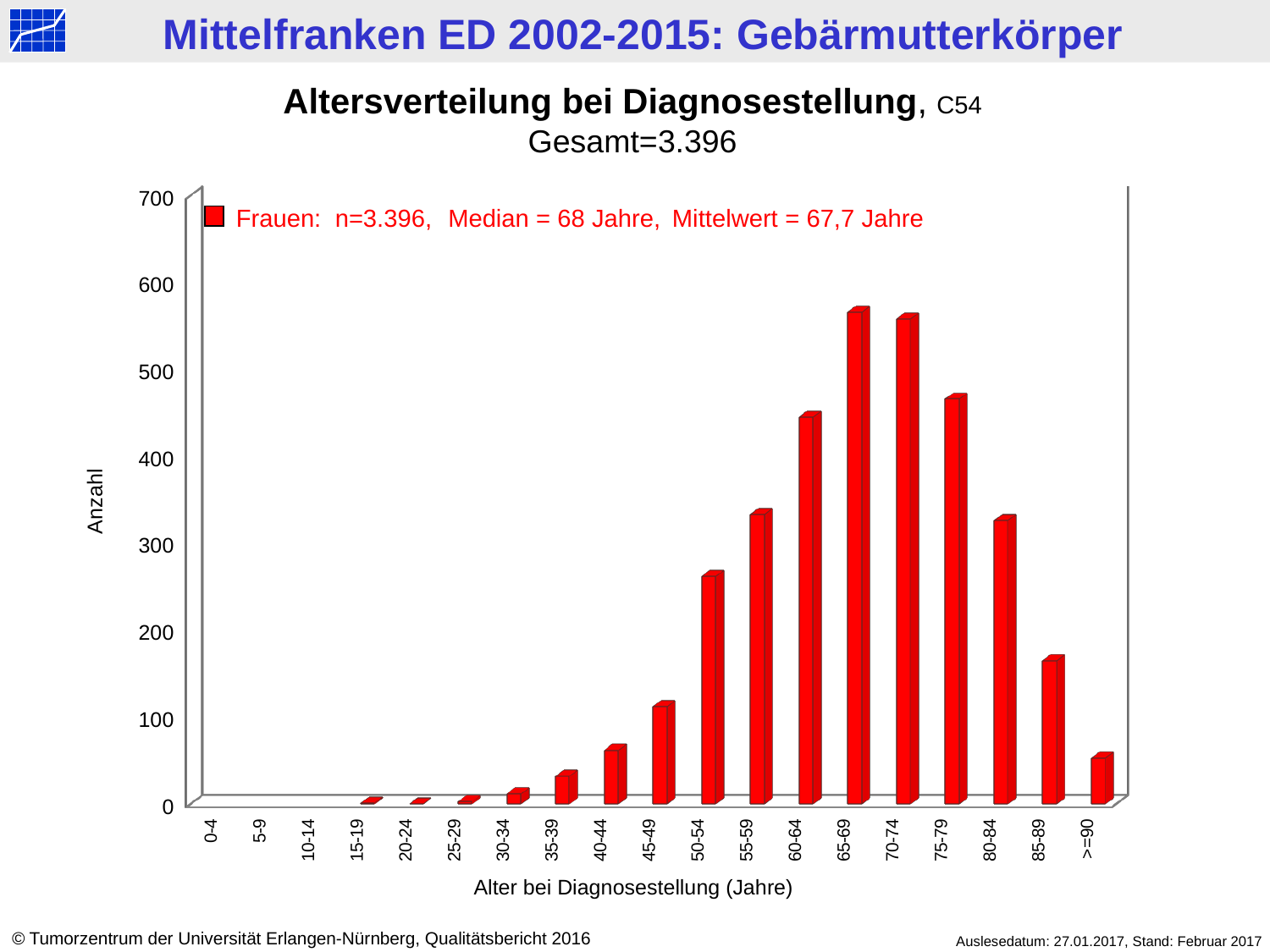
How many series does the legend list? 1 Is the value for the 40-44 age group greater or less than 100? less What is the label of the y axis? Anzahl Which age group has the larger value, 50-54 or 85-89? 50-54 What kind of chart is shown on the slide? bar chart How many age categories are shown on the x axis? 19 Is the value for the 85-89 age group greater or less than 200? less Is the value for the 65-69 age group greater or less than 500? greater What median age is stated in the legend? 68 Jahre Do the values rise or fall from the 70-74 age group to the >=90 age group? fall